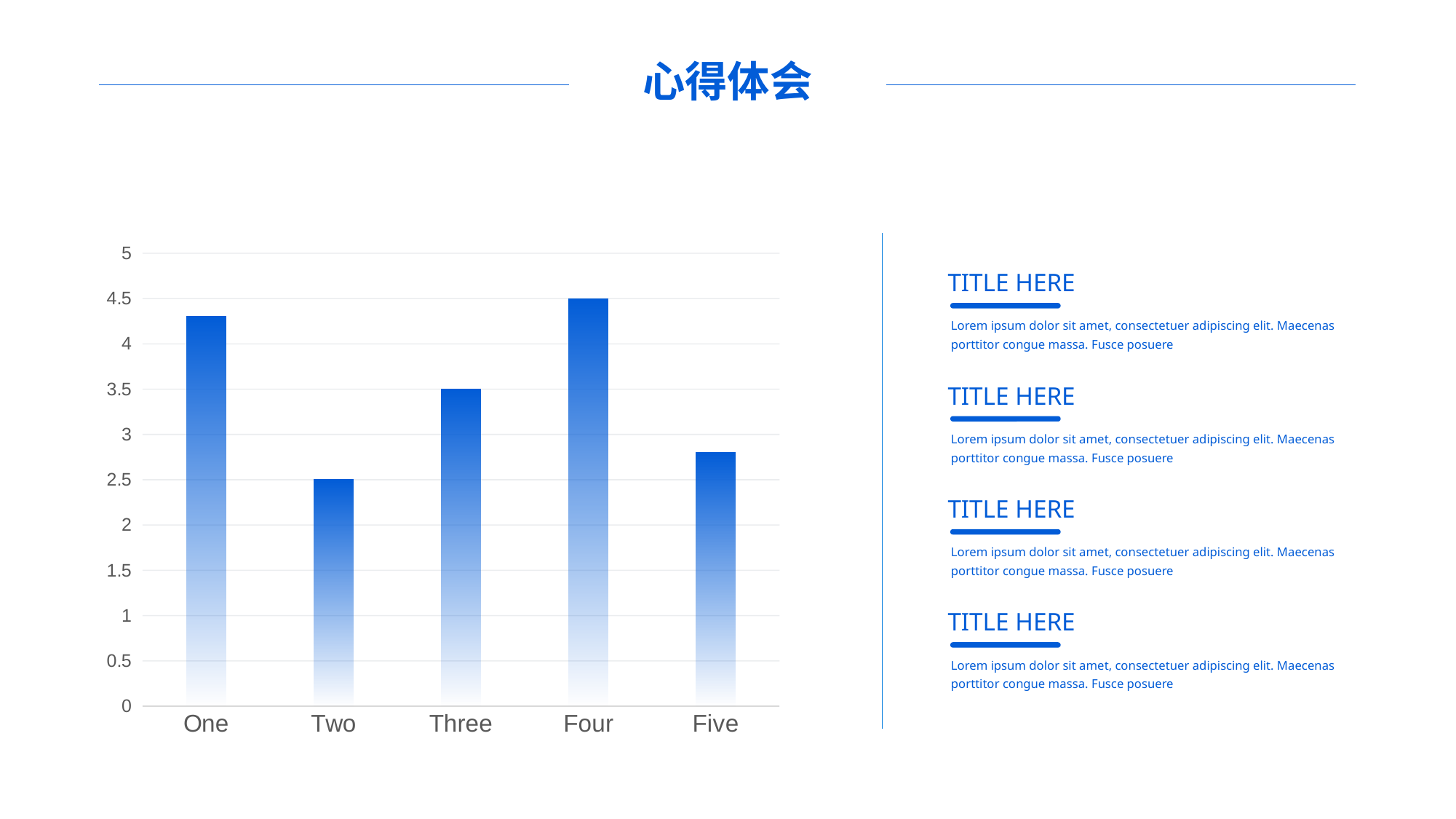
What is the value for Three in the chart? 3.5 What is the difference between the values for Four and Two? 2 Which category has the highest bar in the chart? Four Which category has the lowest bar in the chart? Two What kind of chart is shown on the slide? bar chart What is the value for Four in the chart? 4.5 Is the value for One greater or less than 4? greater Which is larger, the value for One or the value for Three? One Is the value for Five greater or less than 3? less What is the value for Two in the chart? 2.5 What are the category labels on the x axis of the chart? One, Two, Three, Four, Five How many categories are shown on the x axis of the chart? 5